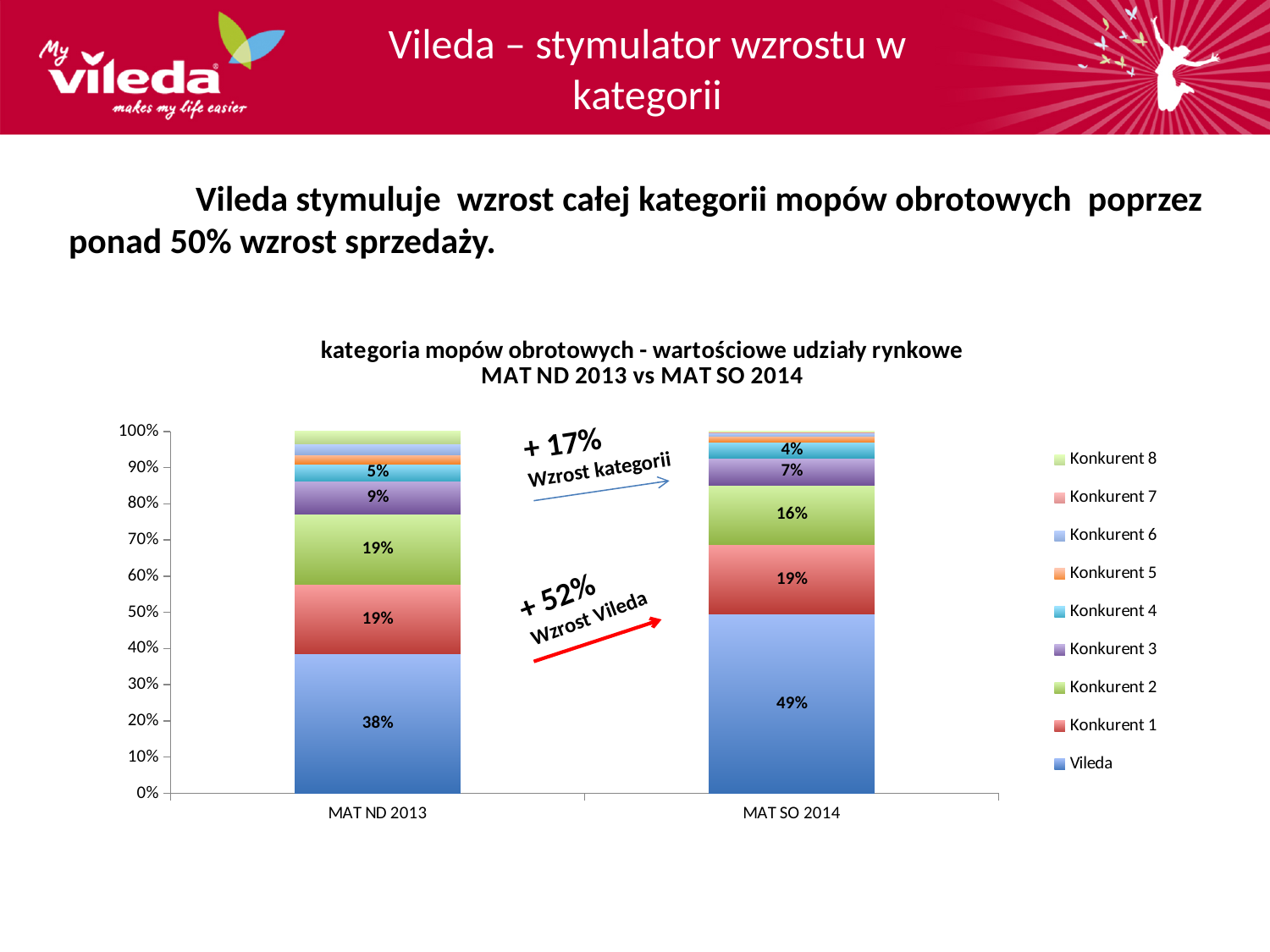
What is the value for Konkurent 3 in MAT ND 2013? 9% What is the value for Vileda in MAT ND 2013? 38% What is the value for Konkurent 4 in MAT SO 2014? 4% What is the value for Konkurent 2 in MAT SO 2014? 16% How many bars (categories) are shown on the x axis? 2 What kind of chart is shown on the slide? Stacked bar chart How many series does the legend list? 9 Which series has the largest segment in the MAT SO 2014 bar? Vileda Which is larger in MAT SO 2014: Konkurent 1 or Konkurent 2? Konkurent 1 What is the value for Vileda in MAT SO 2014? 49% By how many percentage points did Vileda's share change from MAT ND 2013 to MAT SO 2014? 11 percentage points Does Vileda's share rise or fall from MAT ND 2013 to MAT SO 2014? Rise